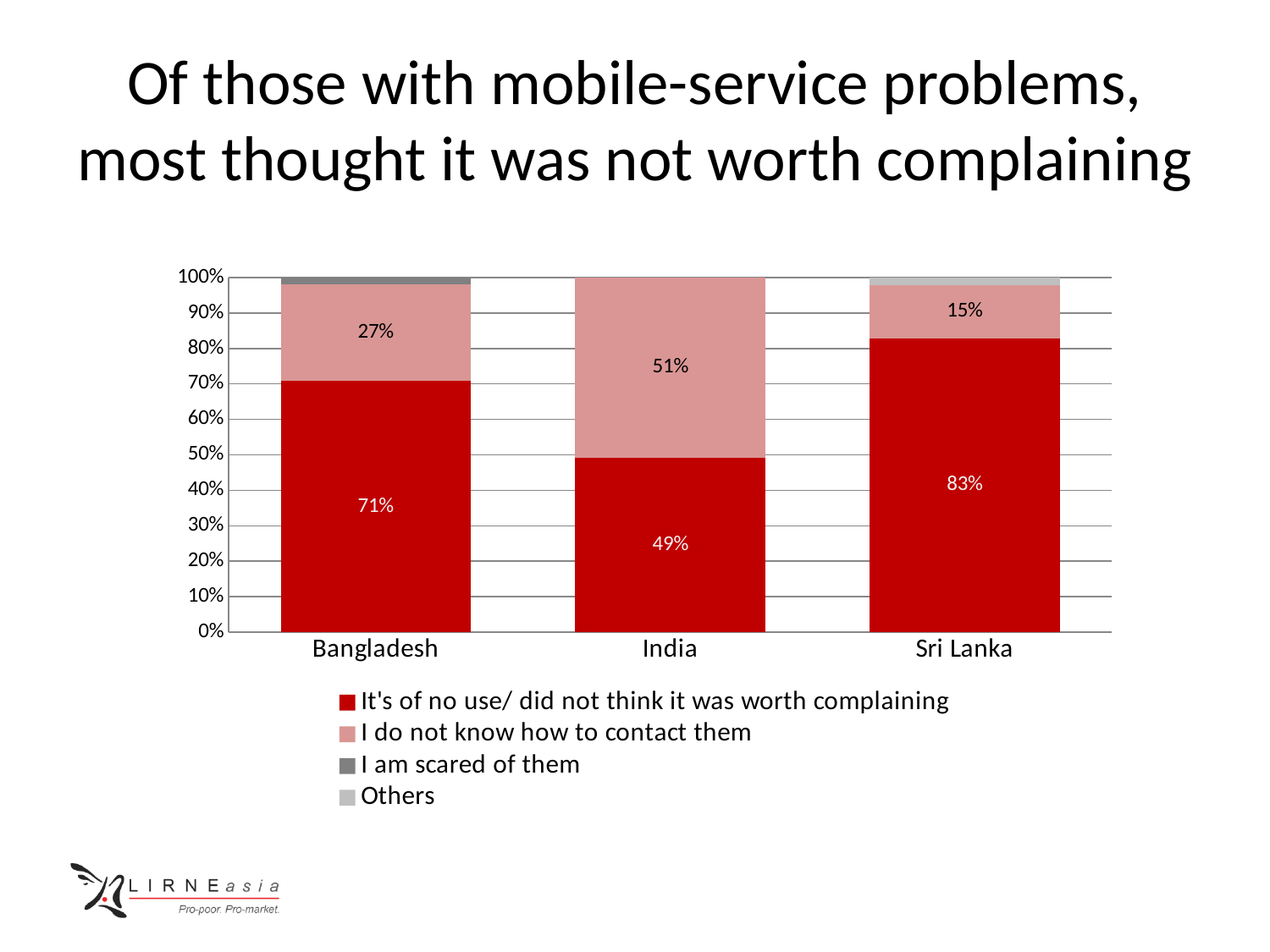
Which country has the highest share of respondents saying it was of no use / not worth complaining? Sri Lanka Which country has the lowest share of respondents saying it was of no use / not worth complaining? India Which legend entry is shown in dark grey? I am scared of them What percentage of respondents in Sri Lanka said they do not know how to contact them? 15% Which is larger: the 'I do not know how to contact them' share in Bangladesh or in India? India How many series does the chart's legend list? 4 How many countries are shown on the x axis of the chart? 3 What is the difference between Sri Lanka's and Bangladesh's shares for 'It's of no use / did not think it was worth complaining'? 12% What percentage of respondents in India said they do not know how to contact them? 51% What kind of chart is shown on the slide? Stacked bar chart What percentage of respondents in Bangladesh said it was of no use / not worth complaining? 71% What percentage of respondents in Sri Lanka said it was of no use / not worth complaining? 83%